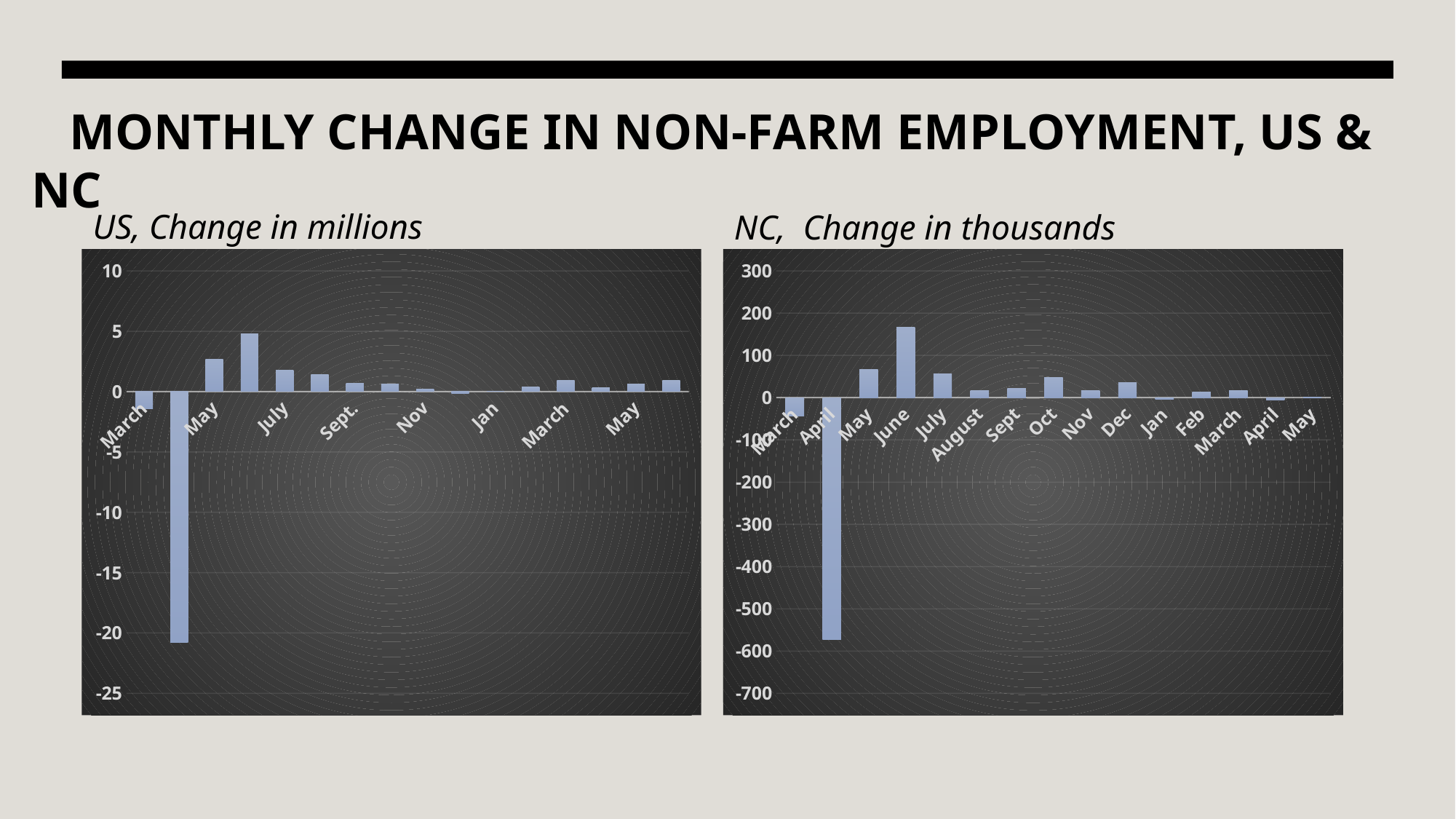
In the 'NC, Change in thousands' chart, is the value for June greater or less than 200? less In the 'NC, Change in thousands' chart, is the value for June greater or less than 100? greater In the 'NC, Change in thousands' chart, which month has the highest value? June What unit does the right-hand chart use for the change in NC employment? thousands In the 'US, Change in millions' chart, is the value for May (the first May shown) greater or less than 5? less In the 'NC, Change in thousands' chart, how many months are shown on the x axis? 15 In the 'NC, Change in thousands' chart, which month has the lowest value? April What kind of chart is the 'US, Change in millions' chart? bar chart In the 'NC, Change in thousands' chart, do the values rise or fall from June to August? fall In the 'NC, Change in thousands' chart, which is larger, the value for Oct or the value for Nov? Oct